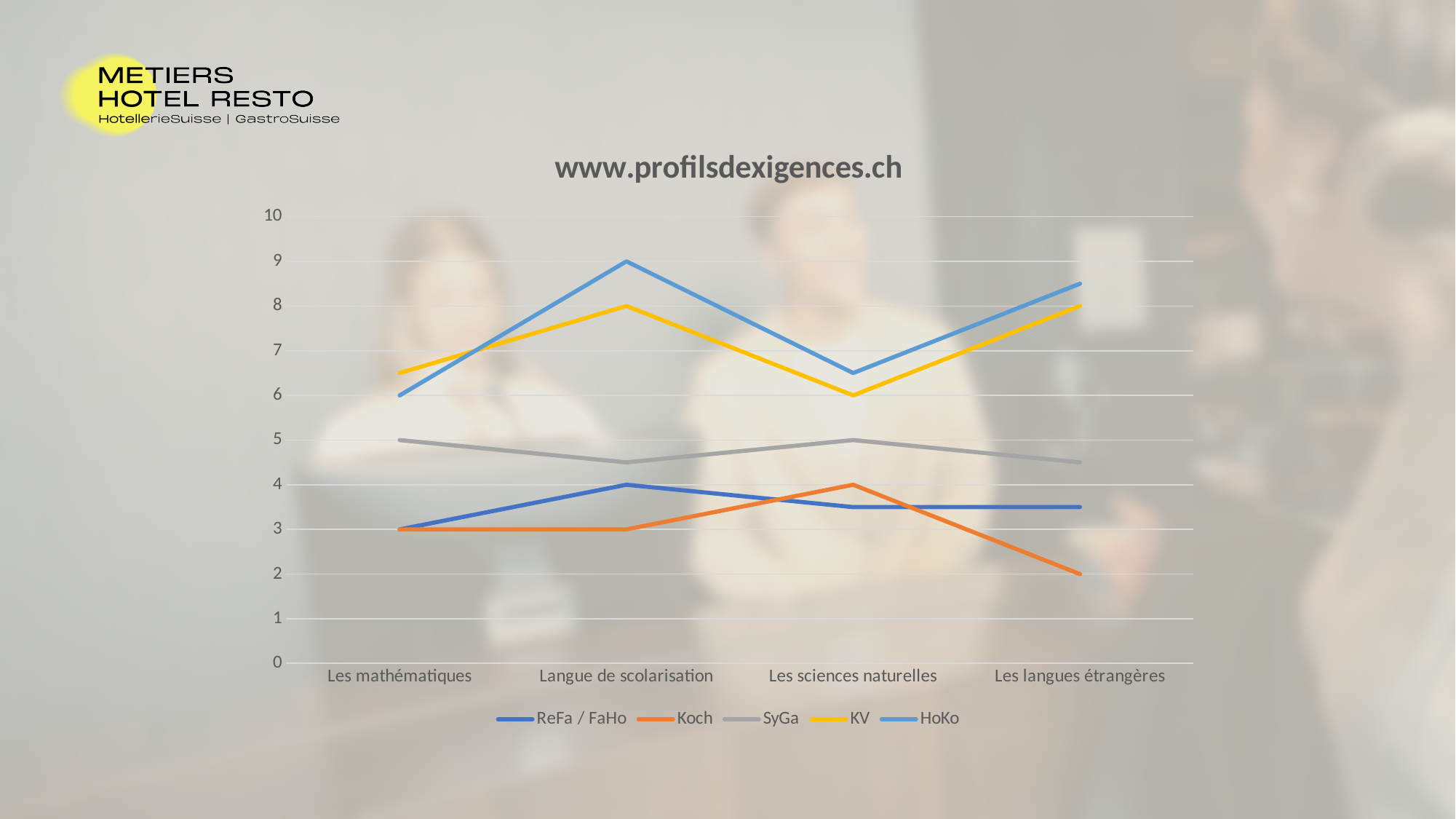
What is the value for SyGa at Les mathématiques? 5 What kind of chart is shown on the slide? line chart What is the value for Koch at Les langues étrangères? 2 What is the title of the chart? www.profilsdexigences.ch What is the value for HoKo at Langue de scolarisation? 9 Which series has the lowest value at Les langues étrangères? Koch Is the value for HoKo at Les langues étrangères greater or less than 8? greater Which series has the highest value at Langue de scolarisation? HoKo How many series does the legend list? 5 How many categories are shown on the x axis? 4 What is the difference between the HoKo value and the KV value at Langue de scolarisation? 1 What is the value for KV at Les sciences naturelles? 6